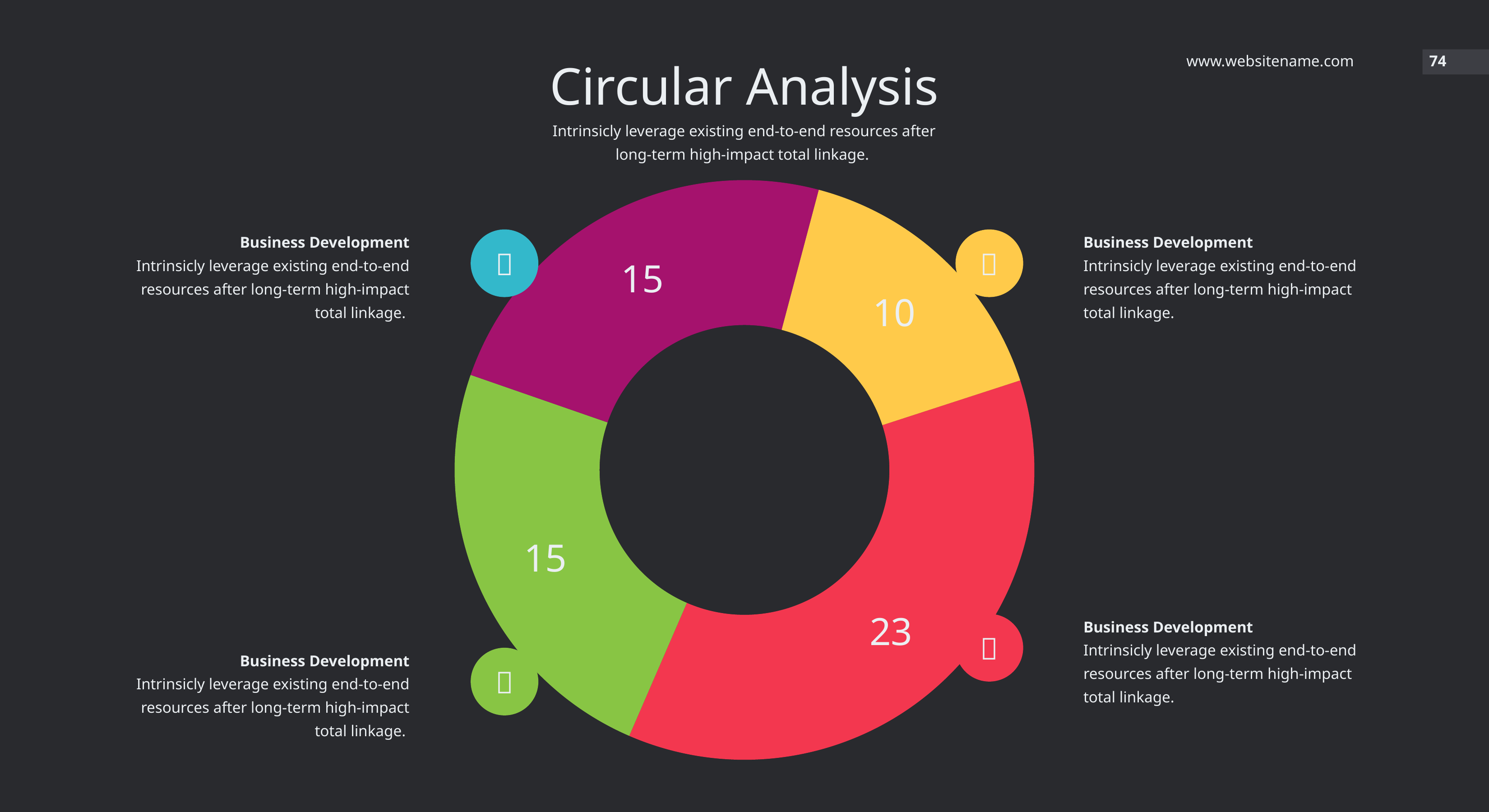
What is the total of all the values shown on the doughnut chart? 63 What type of chart is shown on the slide? Doughnut chart Which slice of the doughnut chart has the lowest value? The yellow slice (10) What is the value shown on the green slice of the doughnut chart? 15 How many slices does the doughnut chart have? 4 Which is larger, the value of the red slice or the value of the green slice? The red slice What is the value shown on the yellow slice of the doughnut chart? 10 What is the title of the chart on the slide? Circular Analysis Which slice of the doughnut chart has the highest value? The red slice (23) What is the difference between the value of the red slice and the value of the yellow slice? 13 What is the value shown on the red slice of the doughnut chart? 23 What is the value shown on the magenta slice of the doughnut chart? 15